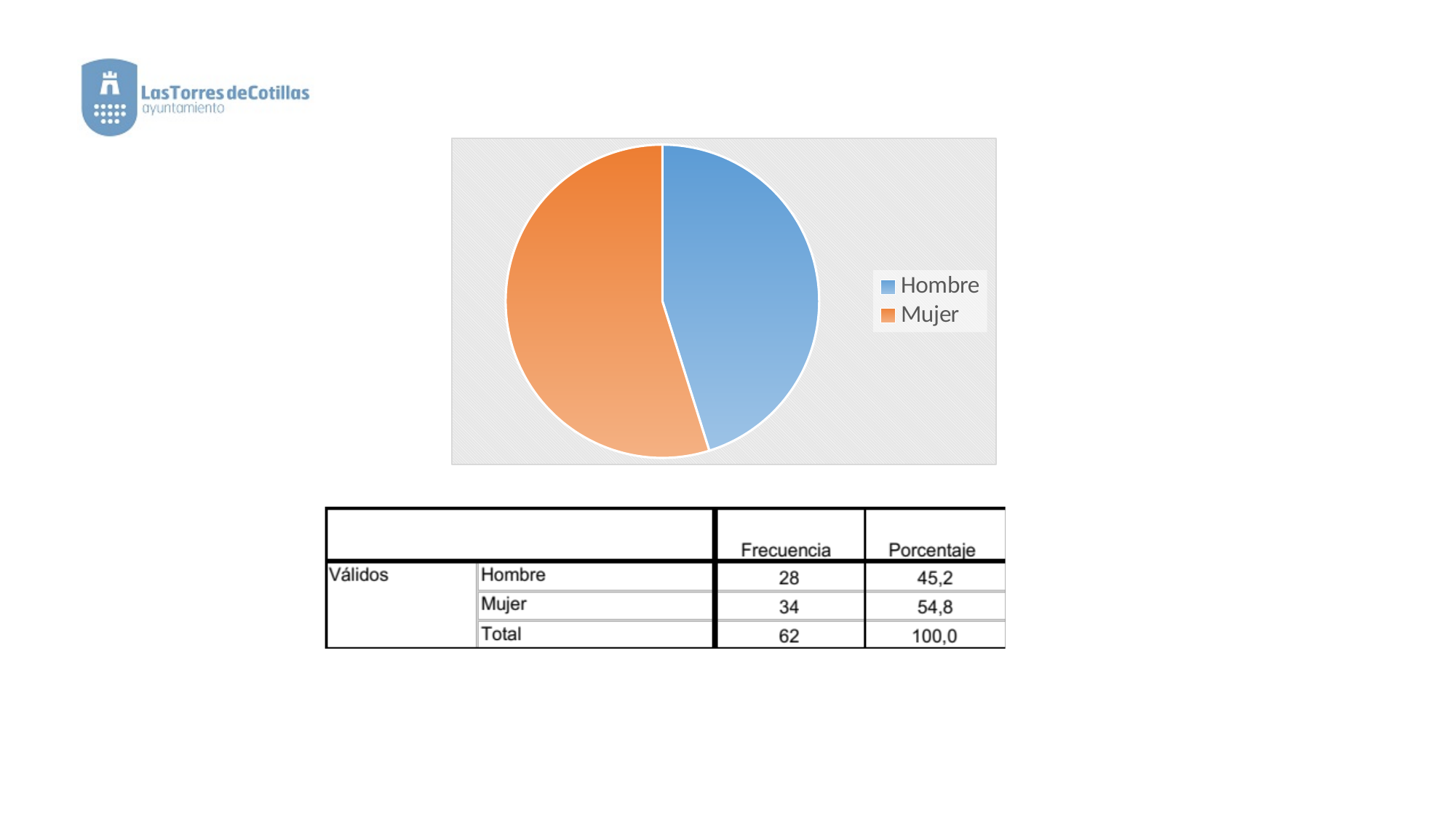
What kind of chart is shown on the slide? pie chart What is the frequency (Frecuencia) for Hombre shown in the table below the pie chart? 28 How many slices does the pie chart have? 2 Which category has the smaller slice in the pie chart? Hombre What percentage (Porcentaje) of the pie does Hombre represent according to the table? 45,2 What is the frequency (Frecuencia) for Mujer shown in the table below the pie chart? 34 What is the difference in frequency between Mujer and Hombre? 6 What percentage (Porcentaje) of the pie does Mujer represent according to the table? 54,8 Which category has the larger slice in the pie chart? Mujer How many entries does the legend of the pie chart list? 2 Is the slice for Mujer larger or smaller than the slice for Hombre? larger What colour is the Hombre slice in the pie chart? blue